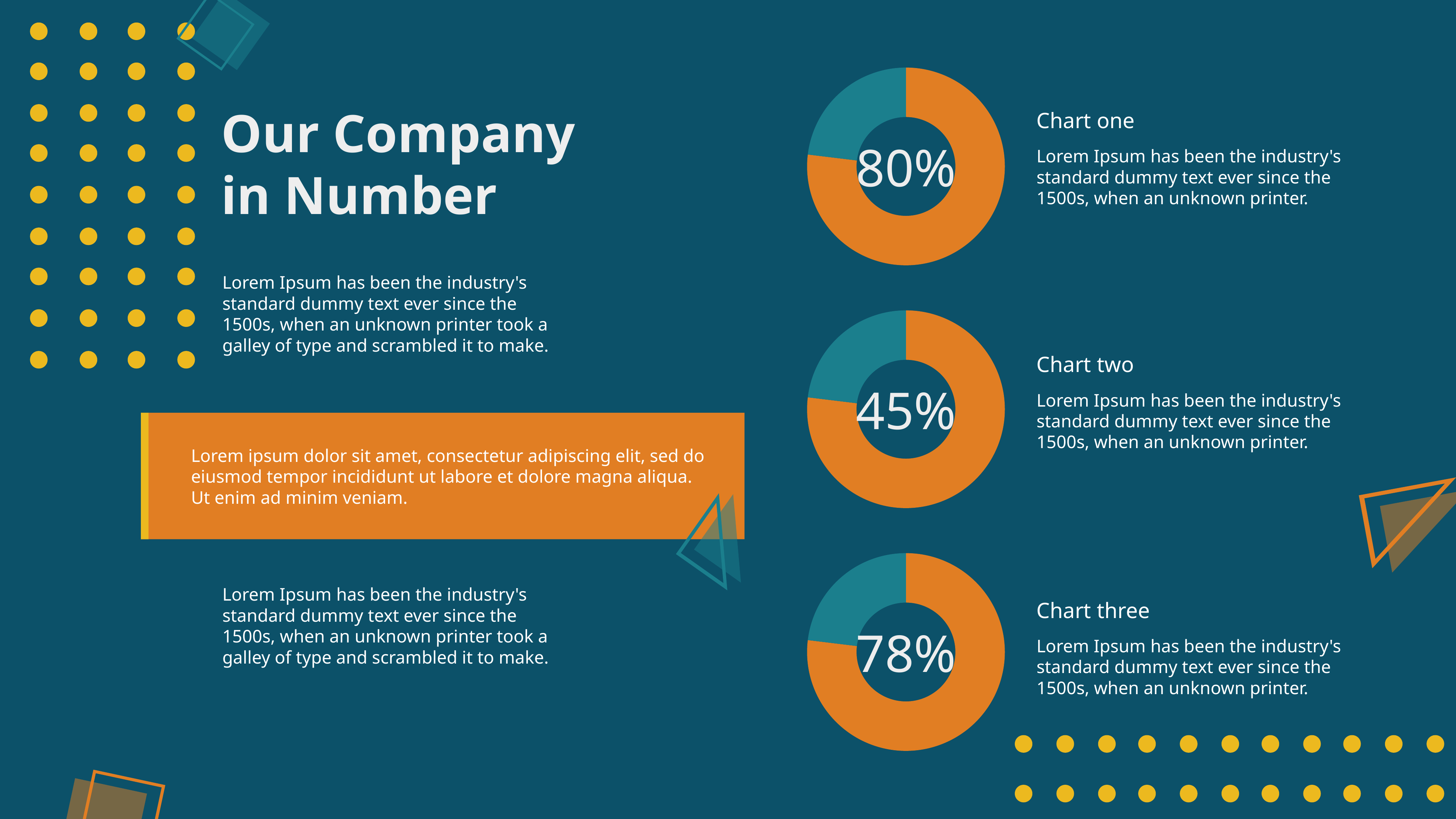
Which of the three charts shows the highest percentage? Chart one What value is shown in the centre of the chart labelled "Chart three"? 78% What value is shown in the centre of the chart labelled "Chart one"? 80% What is the title of the slide containing the three donut charts? Our Company in Number What kind of chart is used for Chart one, Chart two and Chart three? Donut (pie) chart How many donut charts are on the slide? 3 Which shows a larger percentage, Chart two or Chart three? Chart three What is the difference between the percentage shown in Chart one and the percentage shown in Chart two? 35% What is the difference between the percentage shown in Chart one and the percentage shown in Chart three? 2% What two colours are used for the rings of the donut charts? Orange and teal What value is shown in the centre of the chart labelled "Chart two"? 45% Which of the three charts shows the lowest percentage? Chart two